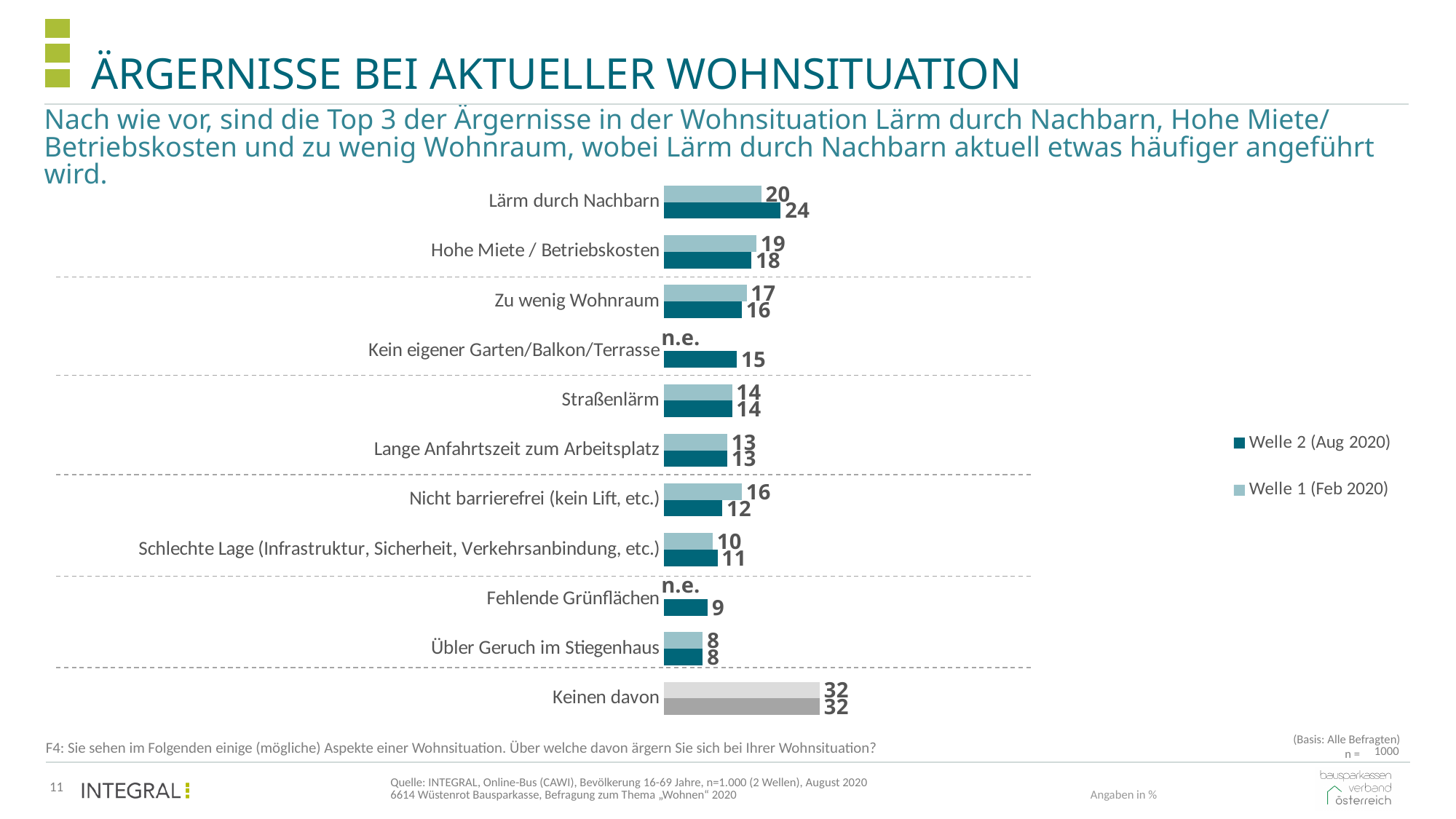
What is the value for Lärm durch Nachbarn in Welle 2 (Aug 2020)? 24 What is shown for Fehlende Grünflächen in Welle 1 (Feb 2020)? n.e. What is the value for Hohe Miete / Betriebskosten in Welle 1 (Feb 2020)? 19 What is the value for Kein eigener Garten/Balkon/Terrasse in Welle 2 (Aug 2020)? 15 Which is larger for Zu wenig Wohnraum: the Welle 1 (Feb 2020) value or the Welle 2 (Aug 2020) value? Welle 1 (Feb 2020) How many series does the legend list? 2 What kind of chart is shown on the slide? Bar chart What is the difference between the Welle 1 (Feb 2020) and Welle 2 (Aug 2020) values for Nicht barrierefrei (kein Lift, etc.)? 4 Which category has the lowest value in Welle 2 (Aug 2020)? Übler Geruch im Stiegenhaus What is the difference between the Welle 2 (Aug 2020) and Welle 1 (Feb 2020) values for Lärm durch Nachbarn? 4 How many categories are shown in the chart, including Keinen davon? 11 Excluding Keinen davon, which category has the highest value in Welle 2 (Aug 2020)? Lärm durch Nachbarn